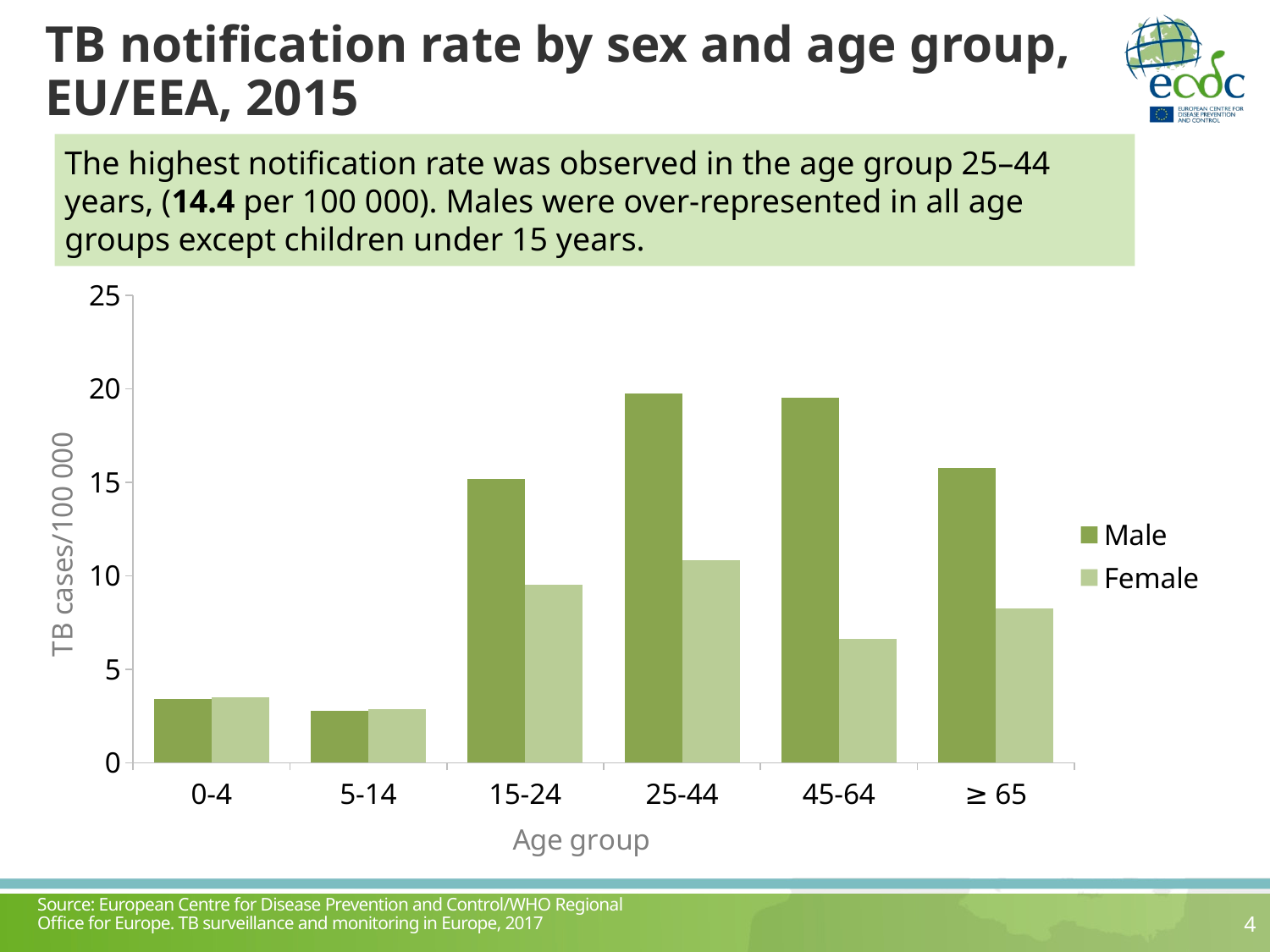
Which is larger, the Female value for 15-24 or the Female value for ≥ 65? 15-24 Is the Male value for the 45-64 age group greater or less than 15? greater How many series does the chart's legend list? 2 How many age groups are shown on the x axis of the chart? 6 Which age group has the lowest Male notification rate? 5-14 What kind of chart is shown on the slide? Bar chart Is the Female value for the 45-64 age group greater or less than 10? less In the 45-64 age group, which is larger, the Male or the Female value? Male Which age group has the highest Female notification rate? 25-44 Is the Female value for the ≥ 65 age group greater or less than 5? greater What is the label on the vertical axis of the chart? TB cases/100 000